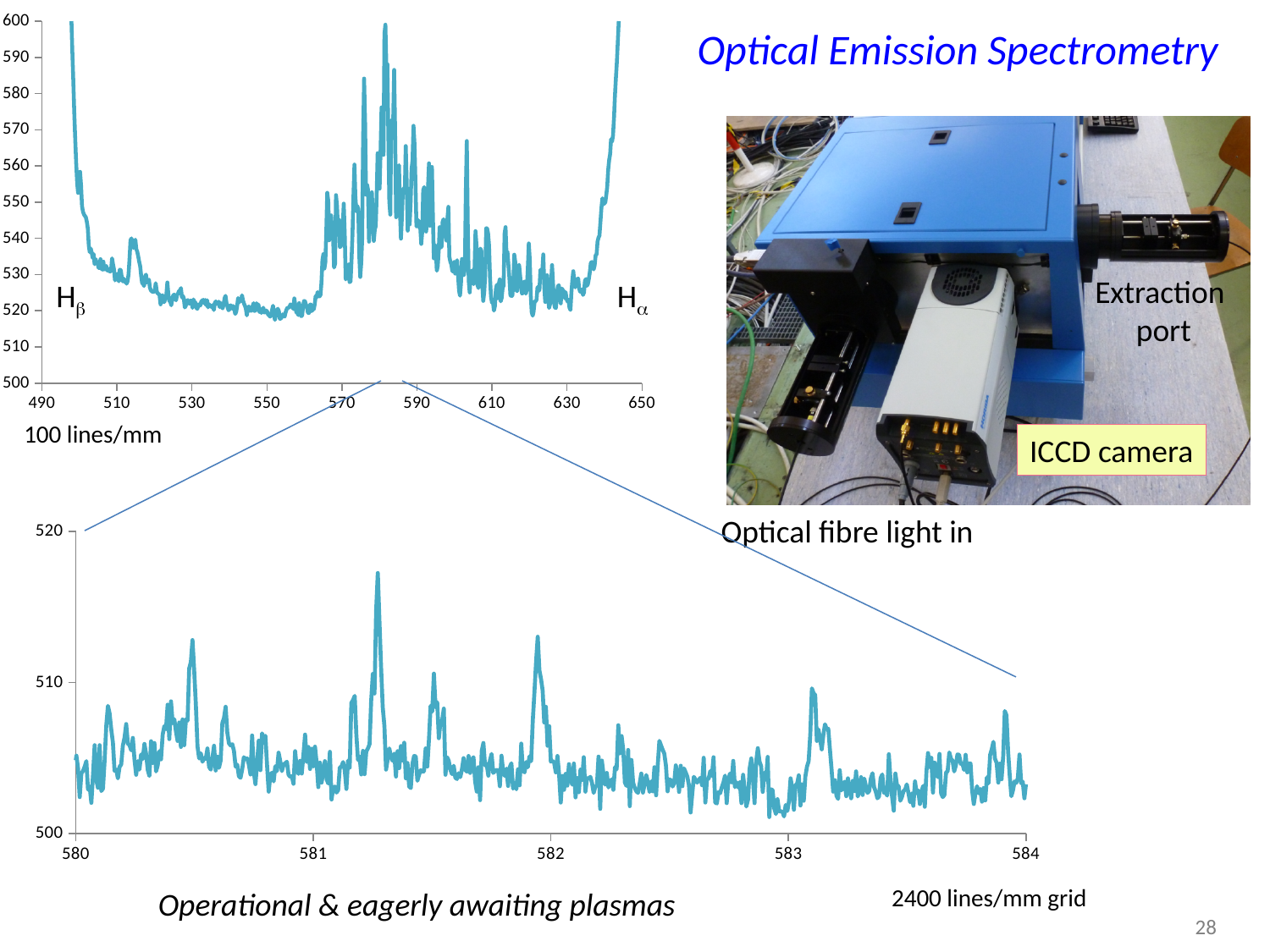
How many charts are shown on the slide? 2 In the bottom chart, is the value at x = 583.5 greater or less than 510? less In the bottom chart, is the peak value near x = 581.25 greater or less than 515? greater In the top-left chart, do the values rise or fall as x goes from 500 to 550? fall In the bottom chart, what is the range of the x axis? 580 to 584 In the top-left chart, what is the range of the x axis? 490 to 650 What kind of chart is the top-left chart on the slide? line chart In the top-left chart, is the value at x = 510 greater or less than 550? less In the top-left chart, what is the highest value shown on the y axis? 600 In the top-left chart, do the values rise or fall as x goes from 630 to 650? rise